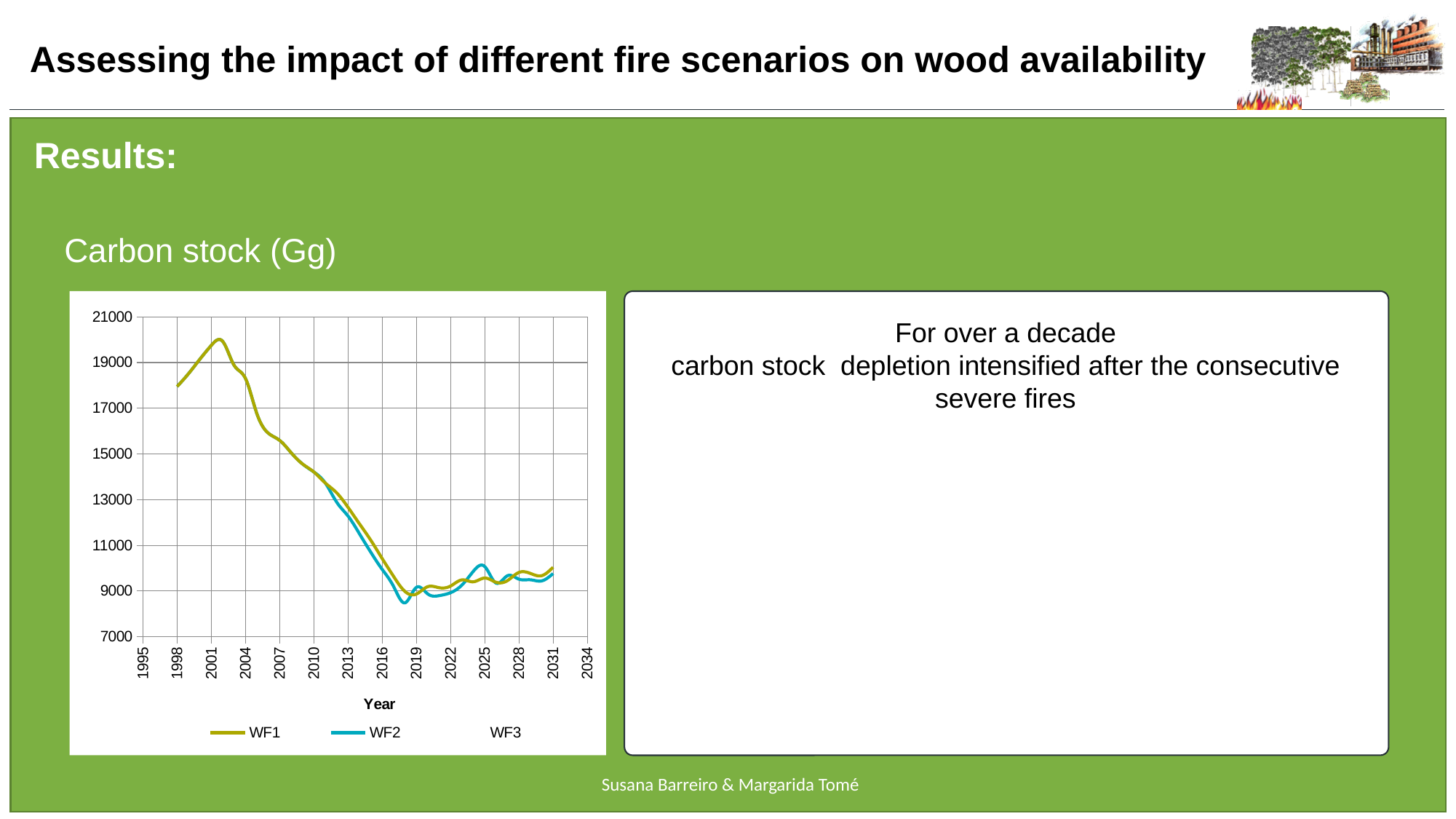
Is the WF1 value in 2001 greater or less than 19000? greater Do the carbon stock values for WF1 rise or fall between 2001 and 2016? fall Is the WF1 value in 2031 greater or less than 9000? greater In 2018, which series has the higher carbon stock, WF1 or WF2? WF1 In 2025, which series has the higher carbon stock, WF1 or WF2? WF2 Is the WF2 value in 2018 greater or less than 9000? less What kind of chart is shown on the slide? line chart What are the series names listed in the chart legend? WF1, WF2, WF3 What is the title of the x axis of the chart? Year How many series does the chart legend list? 3